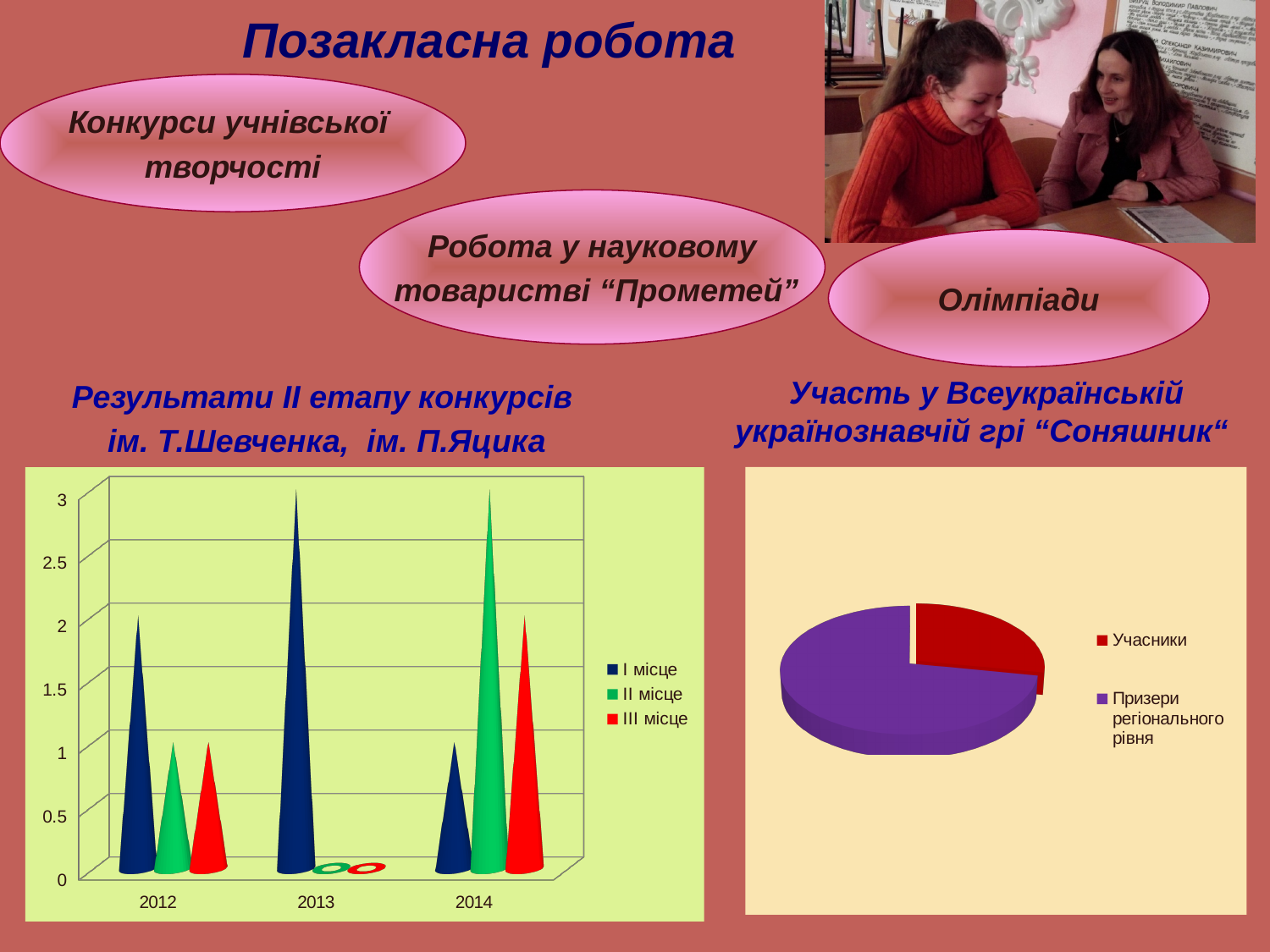
In the left chart "Результати ІІ етапу конкурсів", how many series does the legend list? 3 In the left chart "Результати ІІ етапу конкурсів", what is the value for ІІ місце in 2013? 0 In the left chart "Результати ІІ етапу конкурсів", what is the value for ІІІ місце in 2012? 1 In the right pie chart "Участь у Всеукраїнській українознавчій грі “Соняшник“", which slice is larger: Учасники or Призери регіонального рівня? Призери регіонального рівня What kind of chart is the right chart titled "Участь у Всеукраїнській українознавчій грі “Соняшник“"? pie chart In the left chart "Результати ІІ етапу конкурсів", how many years are shown on the x axis? 3 What kind of chart is the left chart titled "Результати ІІ етапу конкурсів ім. Т.Шевченка, ім. П.Яцика"? bar chart In the left chart "Результати ІІ етапу конкурсів", what is the value for ІІ місце in 2014? 3 In the left chart "Результати ІІ етапу конкурсів", what is the difference between the І місце values for 2012 and 2014? 1 In the left chart "Результати ІІ етапу конкурсів", which is larger in 2014: ІІ місце or ІІІ місце? ІІ місце In the left chart "Результати ІІ етапу конкурсів", which year has the highest value for І місце? 2013 In the left chart "Результати ІІ етапу конкурсів", what is the value for І місце in 2013? 3